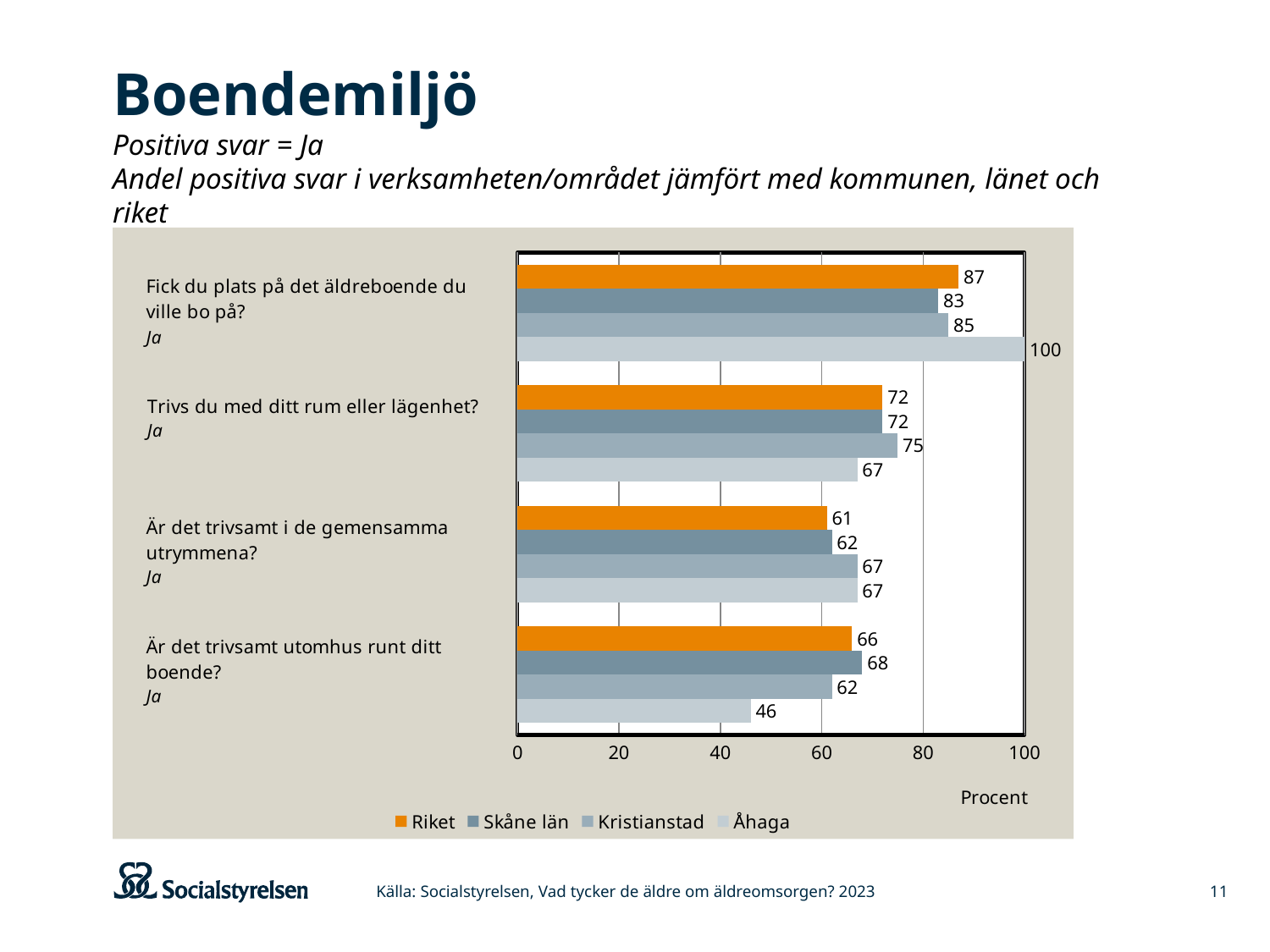
What is the value for Riket on "Trivs du med ditt rum eller lägenhet?"? 72 What is the value for Åhaga on "Fick du plats på det äldreboende du ville bo på?"? 100 Is the value for Åhaga on "Är det trivsamt utomhus runt ditt boende?" greater or less than 60? less What is the difference between the Åhaga value and the Riket value on "Är det trivsamt utomhus runt ditt boende?"? 20 What kind of chart is shown on the slide? bar chart How many series does the legend list? 4 Which series has the highest value on "Fick du plats på det äldreboende du ville bo på?"? Åhaga On "Trivs du med ditt rum eller lägenhet?", which is larger: the Kristianstad value or the Åhaga value? Kristianstad Which series has the lowest value on "Är det trivsamt utomhus runt ditt boende?"? Åhaga What is the value for Kristianstad on "Är det trivsamt i de gemensamma utrymmena?"? 67 How many questions (categories) are shown in the chart? 4 What is the value for Skåne län on "Är det trivsamt utomhus runt ditt boende?"? 68